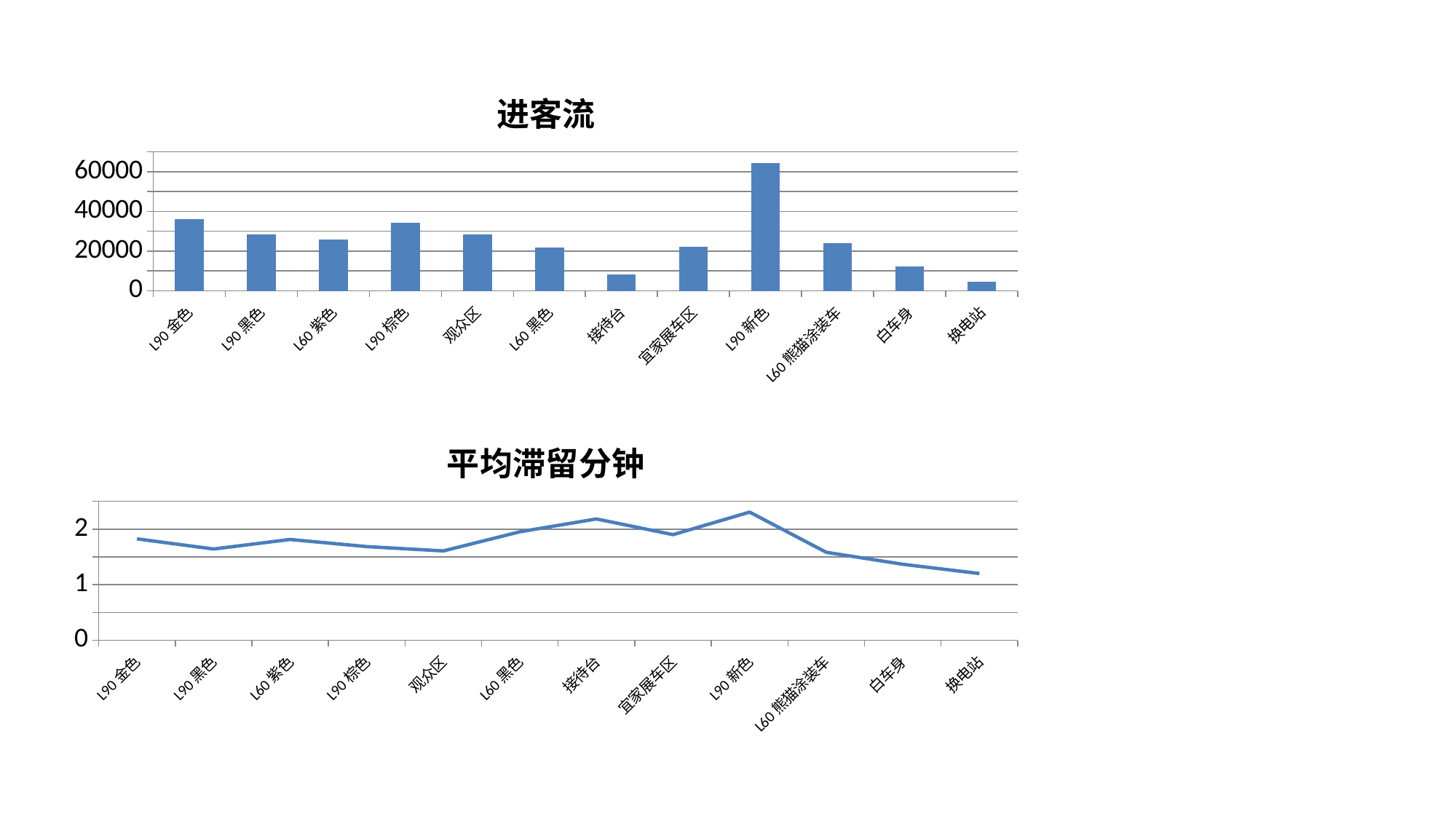
In the 平均滞留分钟 chart, is the value for 接待台 greater or less than 2? greater In the 进客流 chart, which category has the highest value? L90 新色 What kind of chart is the 进客流 chart? bar chart In the 平均滞留分钟 chart, do the values rise or fall from L90 新色 to 换电站? fall In the 平均滞留分钟 chart, which category has the lowest value? 换电站 In the 平均滞留分钟 chart, which category has the highest value? L90 新色 In the 进客流 chart, which is larger, L90 金色 or L90 黑色? L90 金色 In the 进客流 chart, which category has the lowest value? 换电站 How many categories are shown on the x axis of the 进客流 chart? 12 In the 进客流 chart, is the value for L90 新色 greater or less than 60000? greater In the 进客流 chart, is the value for 接待台 greater or less than 20000? less What kind of chart is the 平均滞留分钟 chart? line chart